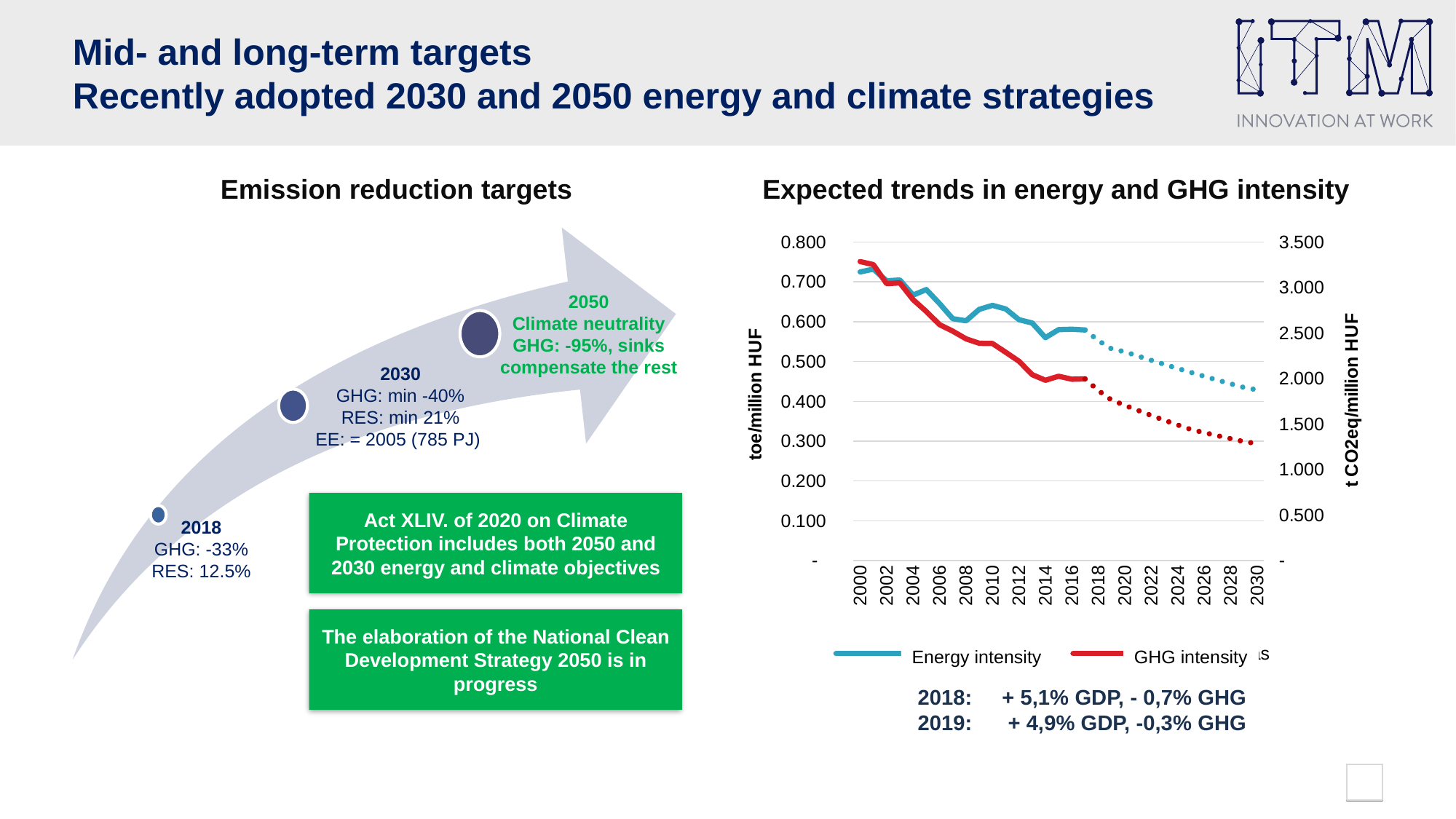
In the 'Expected trends in energy and GHG intensity' chart, does the GHG intensity series rise or fall from 2000 to 2030? fall How many year labels are shown on the x axis of the 'Expected trends in energy and GHG intensity' chart? 16 Which series in the 'Expected trends in energy and GHG intensity' chart is drawn in red? GHG intensity In the 'Expected trends in energy and GHG intensity' chart, is the GHG intensity value for 2000 greater or less than 3.000 on the right axis? greater In the 'Expected trends in energy and GHG intensity' chart, is the Energy intensity value for 2010 greater or less than 0.600 on the left axis? greater In the 'Expected trends in energy and GHG intensity' chart, does the Energy intensity series rise or fall from 2000 to 2030? fall How many series does the legend of the 'Expected trends in energy and GHG intensity' chart list? 2 What is the label of the left vertical axis in the 'Expected trends in energy and GHG intensity' chart? toe/million HUF In the 'Expected trends in energy and GHG intensity' chart, is the GHG intensity value for 2030 greater or less than 1.500 on the right axis? less What kind of chart is shown under 'Expected trends in energy and GHG intensity'? line chart